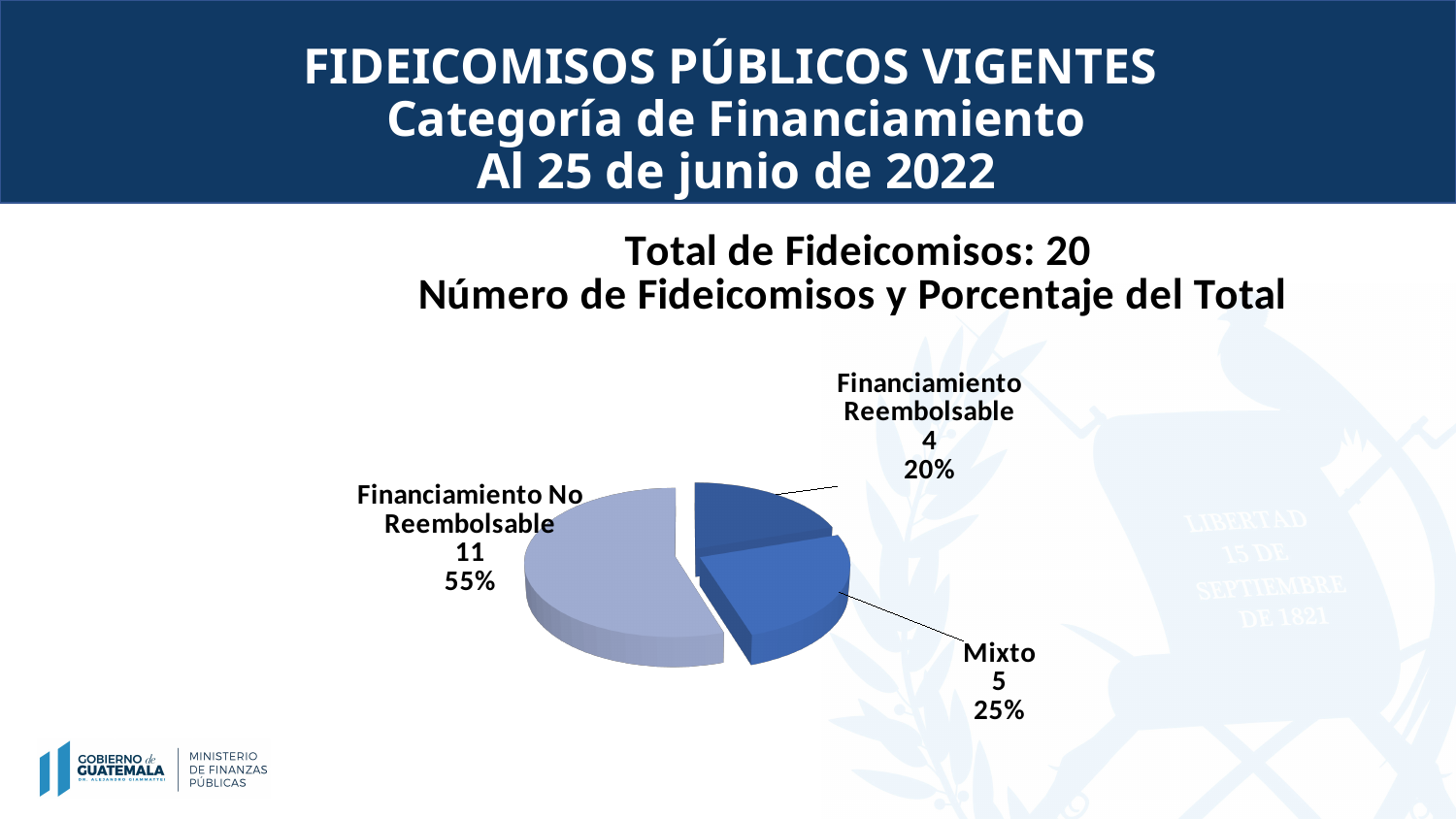
What percentage of the total does Financiamiento No Reembolsable represent? 55% Which category has the largest number of fideicomisos? Financiamiento No Reembolsable How many fideicomisos are in the Financiamiento No Reembolsable category? 11 What percentage of the total does Mixto represent? 25% Which category has the smallest number of fideicomisos? Financiamiento Reembolsable What is the date stated in the slide title? Al 25 de junio de 2022 What is the difference in the number of fideicomisos between Financiamiento No Reembolsable and Mixto? 6 How many fideicomisos are in the Financiamiento Reembolsable category? 4 What is the total number of fideicomisos shown on the slide? 20 How many categories are shown in the pie chart? 3 Which has more fideicomisos, Mixto or Financiamiento Reembolsable? Mixto What kind of chart is shown on the slide? Pie chart